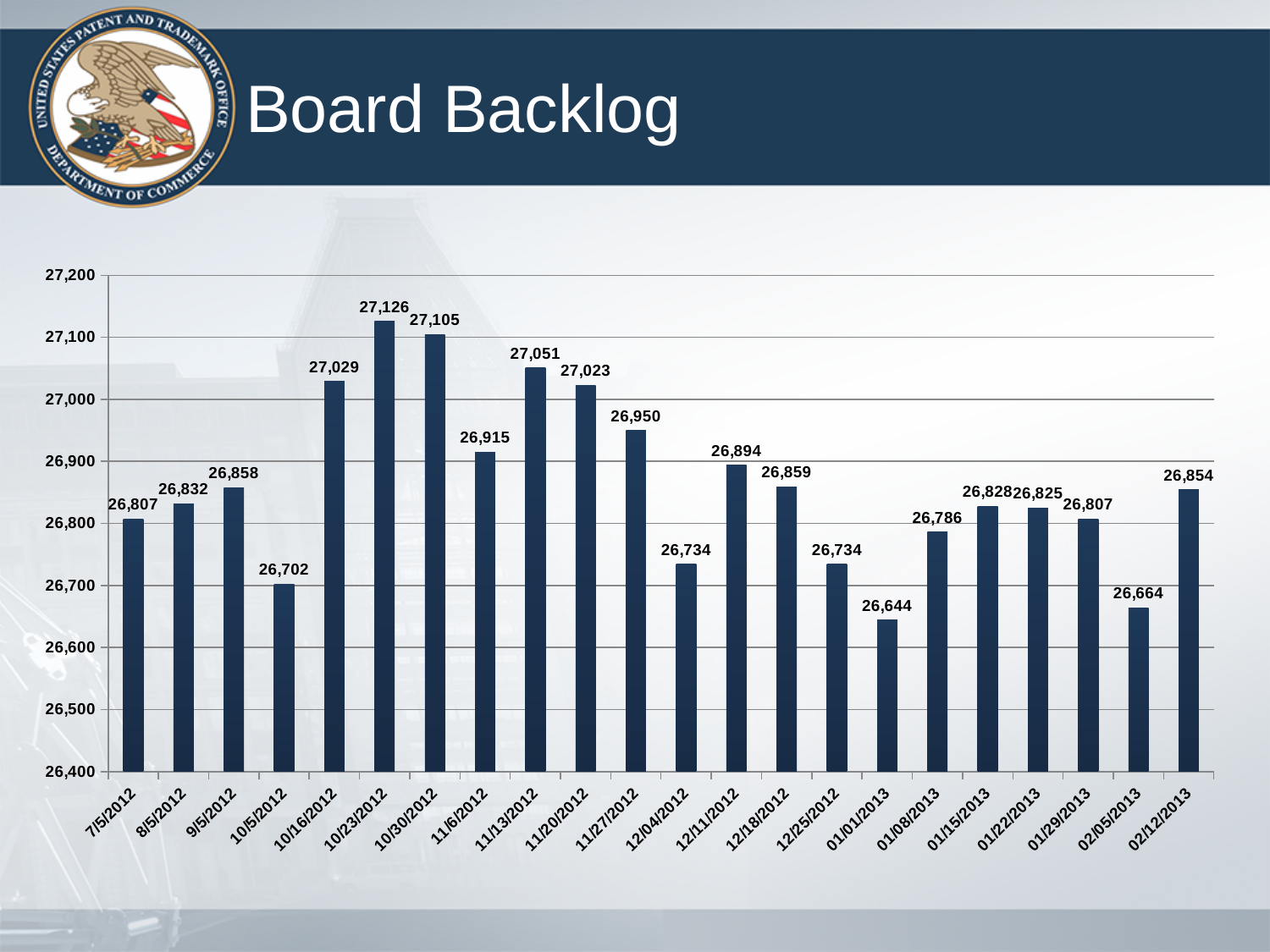
What is the difference between the values for 10/16/2012 and 10/5/2012? 327 Which is larger, the value for 11/13/2012 or the value for 11/20/2012? 11/13/2012 What is the Board Backlog value for 10/5/2012? 26,702 Which date has the highest Board Backlog? 10/23/2012 How many dates are shown on the x axis of the chart? 22 What is the Board Backlog value for 01/01/2013? 26,644 What is the difference between the highest value (10/23/2012) and the lowest value (01/01/2013)? 482 Is the value for 11/27/2012 greater or less than 27,000? less What is the Board Backlog value for 10/23/2012? 27,126 What is the Board Backlog value for 02/12/2013? 26,854 What kind of chart is shown on the slide? bar chart Which date has the lowest Board Backlog? 01/01/2013